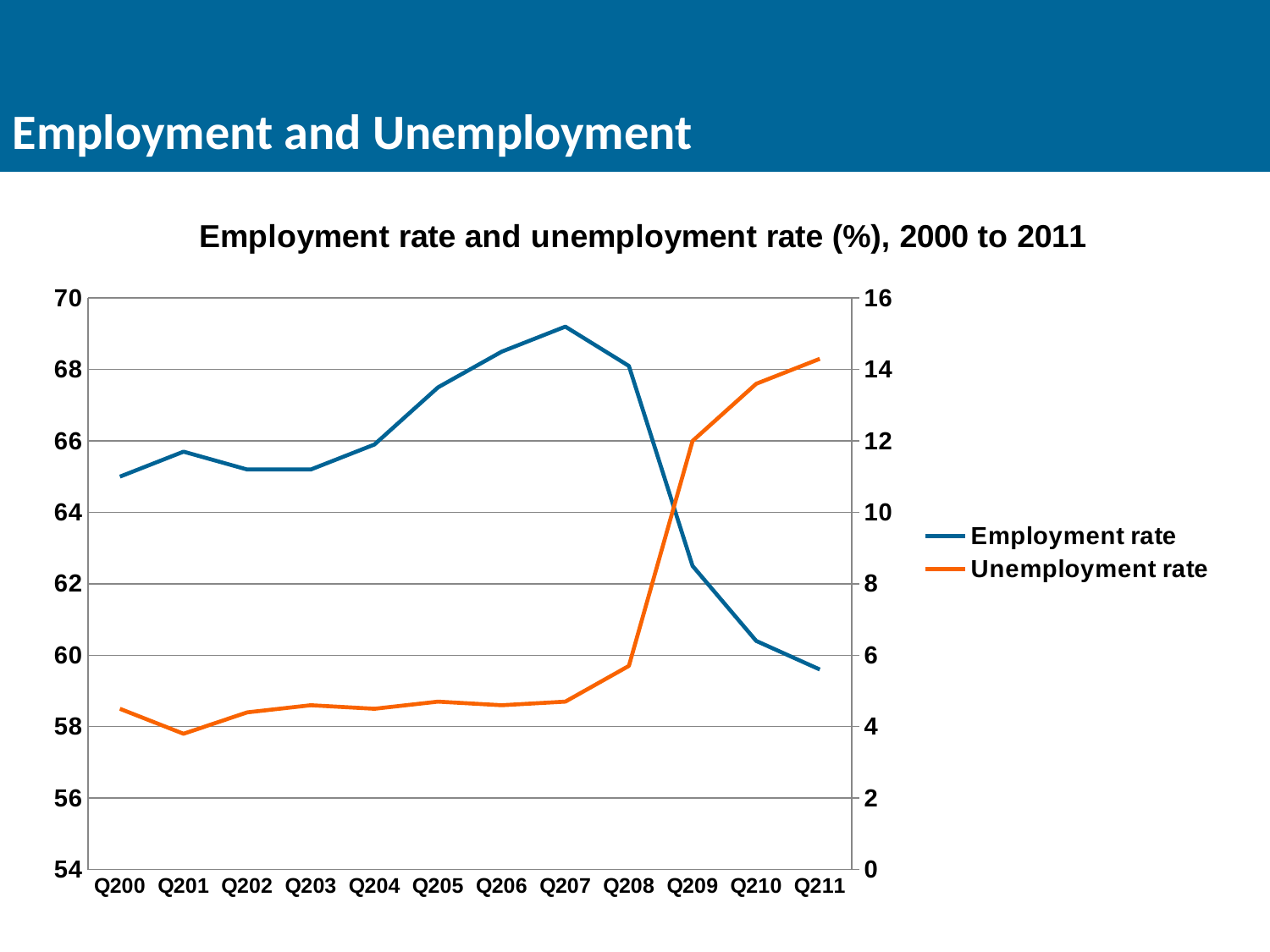
How many series does the legend list? 2 In which quarter is the Unemployment rate at its lowest? Q201 Does the Employment rate rise or fall from Q208 to Q211? fall Is the Employment rate for Q211 greater or less than 60? less What kind of chart is shown on the slide? Line chart How many time points are plotted along the x axis? 12 Is the Employment rate for Q207 greater or less than 68? greater In which quarter is the Employment rate at its lowest? Q211 What is the title of the chart? Employment rate and unemployment rate (%), 2000 to 2011 In which quarter does the Employment rate reach its highest value? Q207 In which quarter is the Unemployment rate at its highest? Q211 Is the Unemployment rate for Q211 greater or less than 14? greater